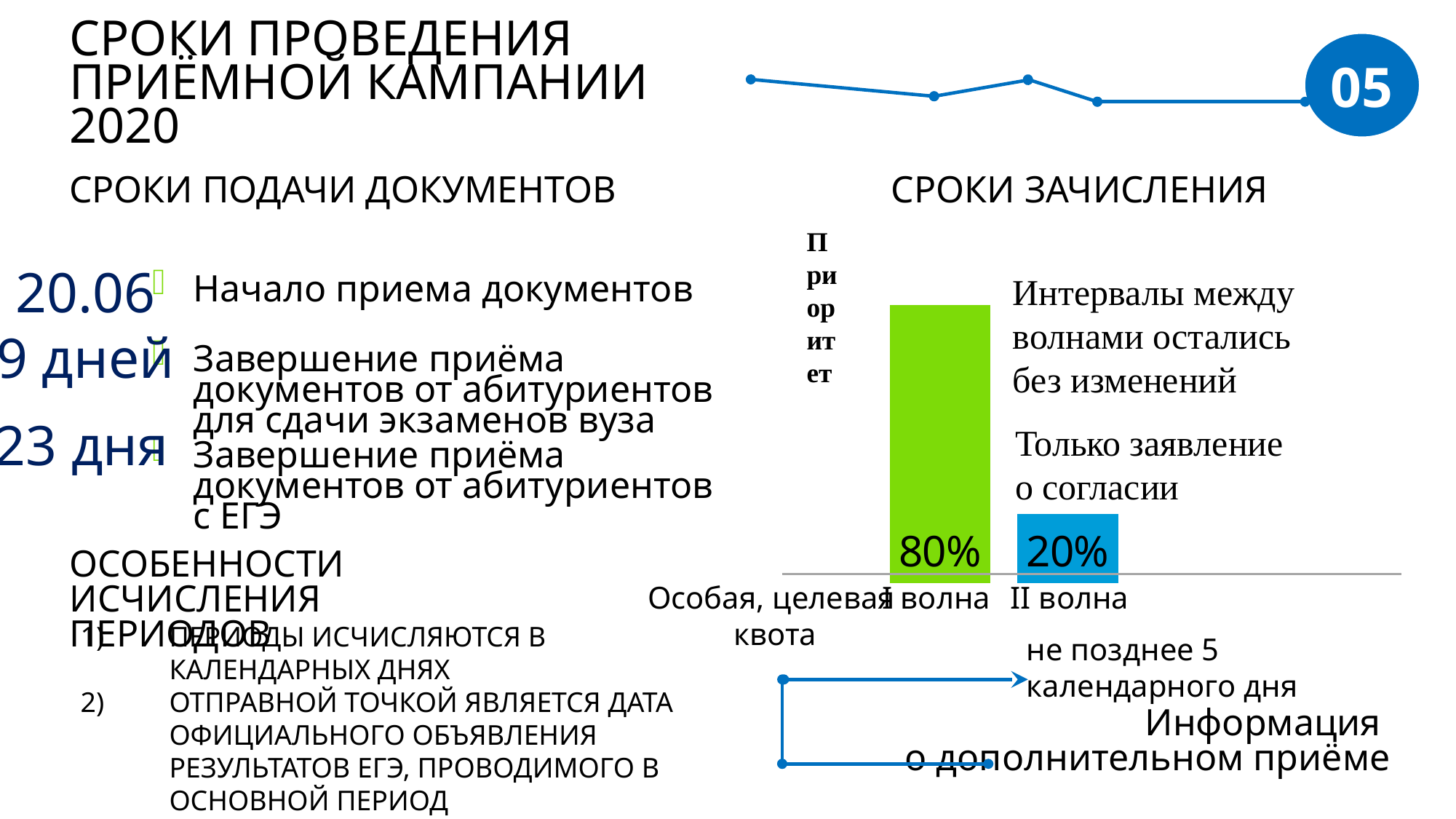
How many categories are labelled on the x axis of the bar chart? 3 What is the label on the vertical axis of the bar chart? Приоритет Which category has the highest bar in the chart? I волна What is the value shown for I волна in the bar chart? 80% What kind of chart is shown under the heading СРОКИ ЗАЧИСЛЕНИЯ? Bar chart What is the difference between the values for I волна and II волна? 60% What colour is the bar for I волна? Green Which of the two waves, I волна or II волна, has the lower value? II волна What is the value shown for II волна in the bar chart? 20% Which is larger, the value for I волна or the value for II волна? I волна